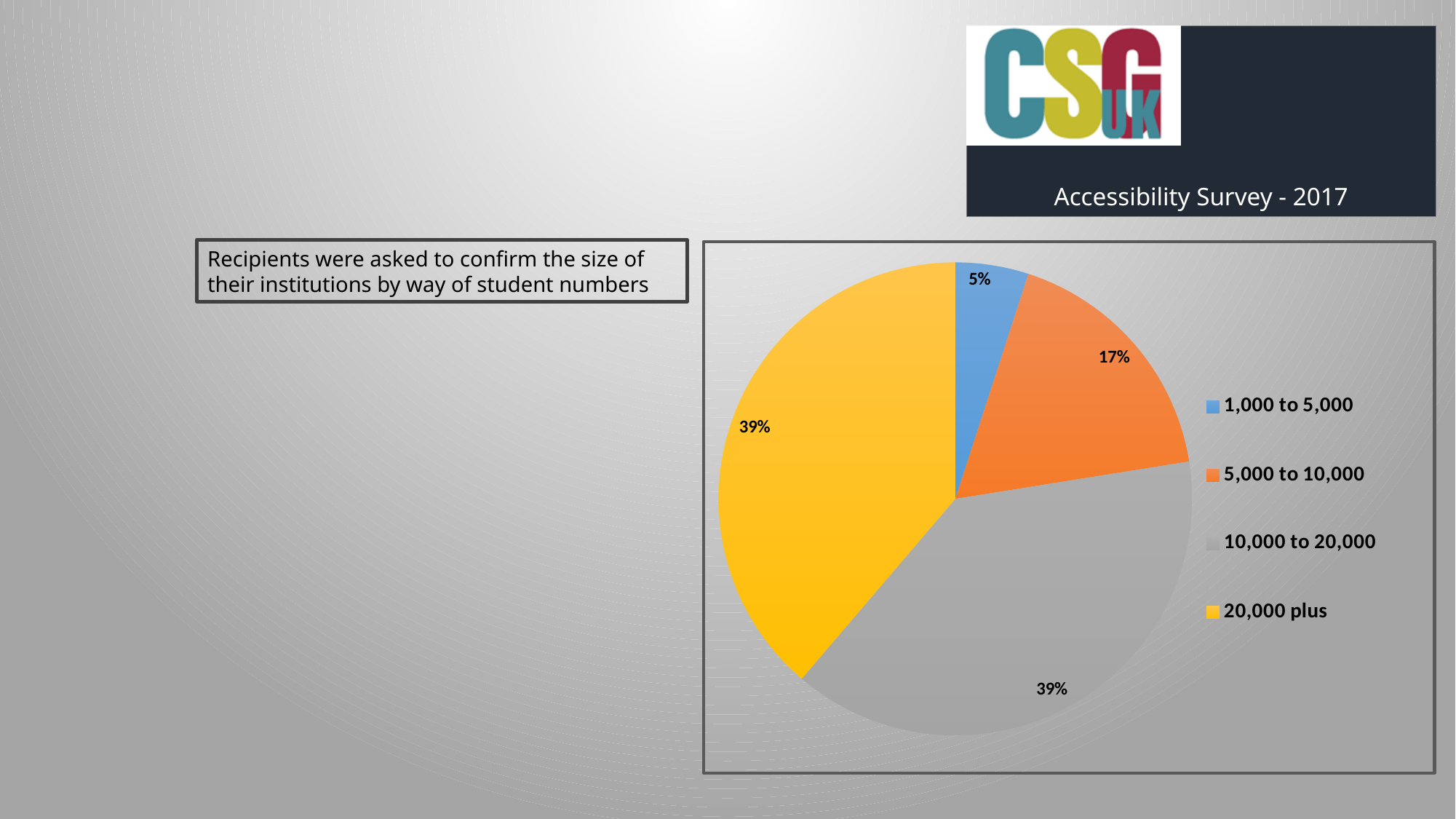
What share of the pie does the 20,000 plus category have? 39% What is the difference in percentage points between the 10,000 to 20,000 slice and the 5,000 to 10,000 slice? 22 What kind of chart is shown on the slide? pie chart Which is larger, the 5,000 to 10,000 slice or the 1,000 to 5,000 slice? 5,000 to 10,000 What share of the pie does the 5,000 to 10,000 category have? 17% What share of the pie does the 1,000 to 5,000 category have? 5% Which colour represents the 1,000 to 5,000 category in the pie chart? blue Which category has the smallest slice of the pie? 1,000 to 5,000 Which colour represents the 20,000 plus category in the pie chart? yellow What share of the pie does the 10,000 to 20,000 category have? 39% How many categories does the pie chart show? 4 What is the difference in percentage points between the 5,000 to 10,000 slice and the 1,000 to 5,000 slice? 12